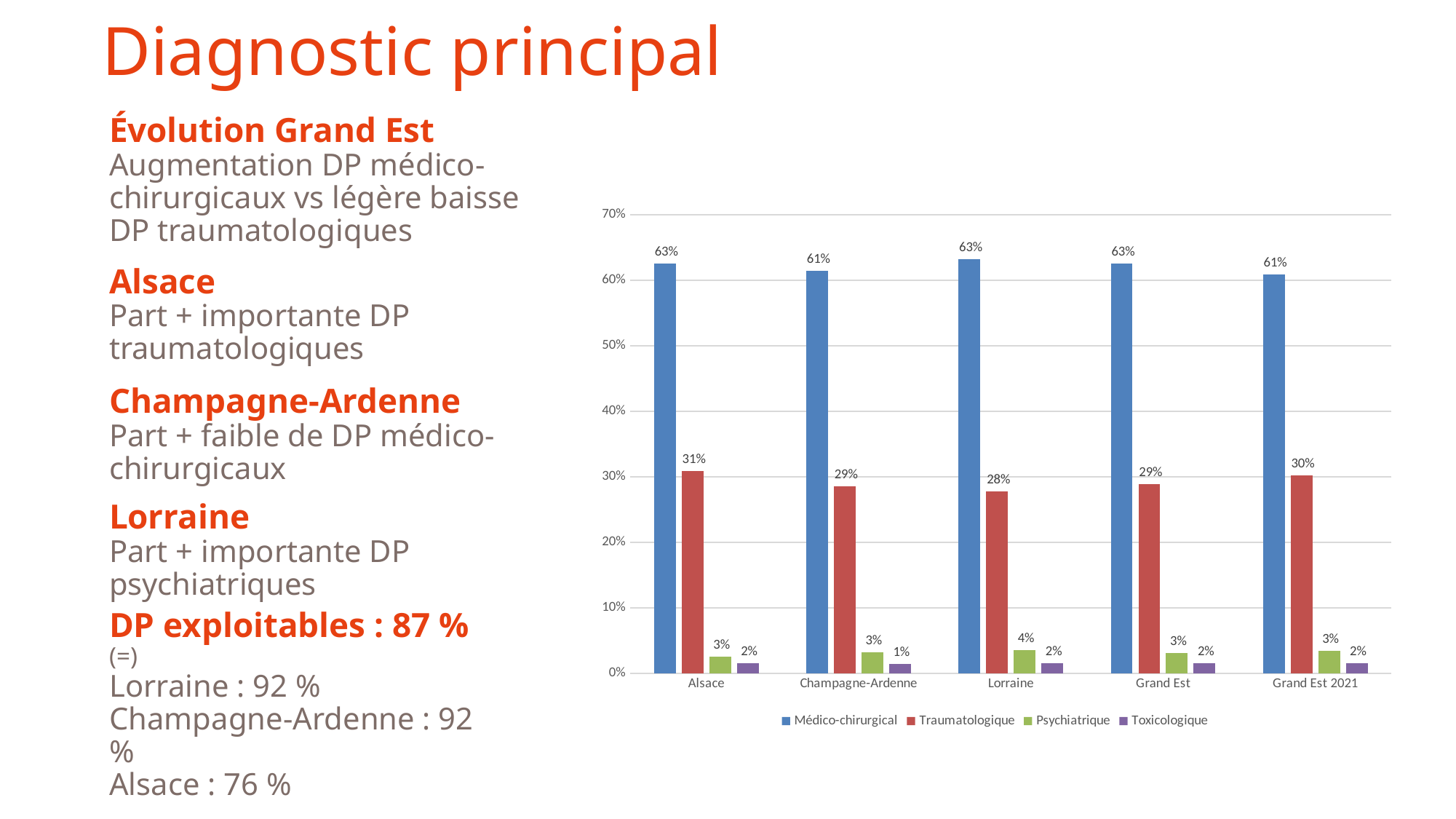
What kind of chart is shown on the slide? Bar chart Which category has the lowest Traumatologique value? Lorraine What is the Psychiatrique value for Lorraine? 4% How many categories are shown on the x axis? 5 What is the Médico-chirurgical value for Champagne-Ardenne? 61% What is the difference between the Médico-chirurgical and Traumatologique values for Alsace? 32% Which is larger for Grand Est: the Traumatologique value or the Psychiatrique value? Traumatologique Which category has the highest Traumatologique value? Alsace What is the Traumatologique value for Alsace? 31% How many series does the legend list? 4 What is the Traumatologique value for Grand Est 2021? 30% What is the Toxicologique value for Champagne-Ardenne? 1%